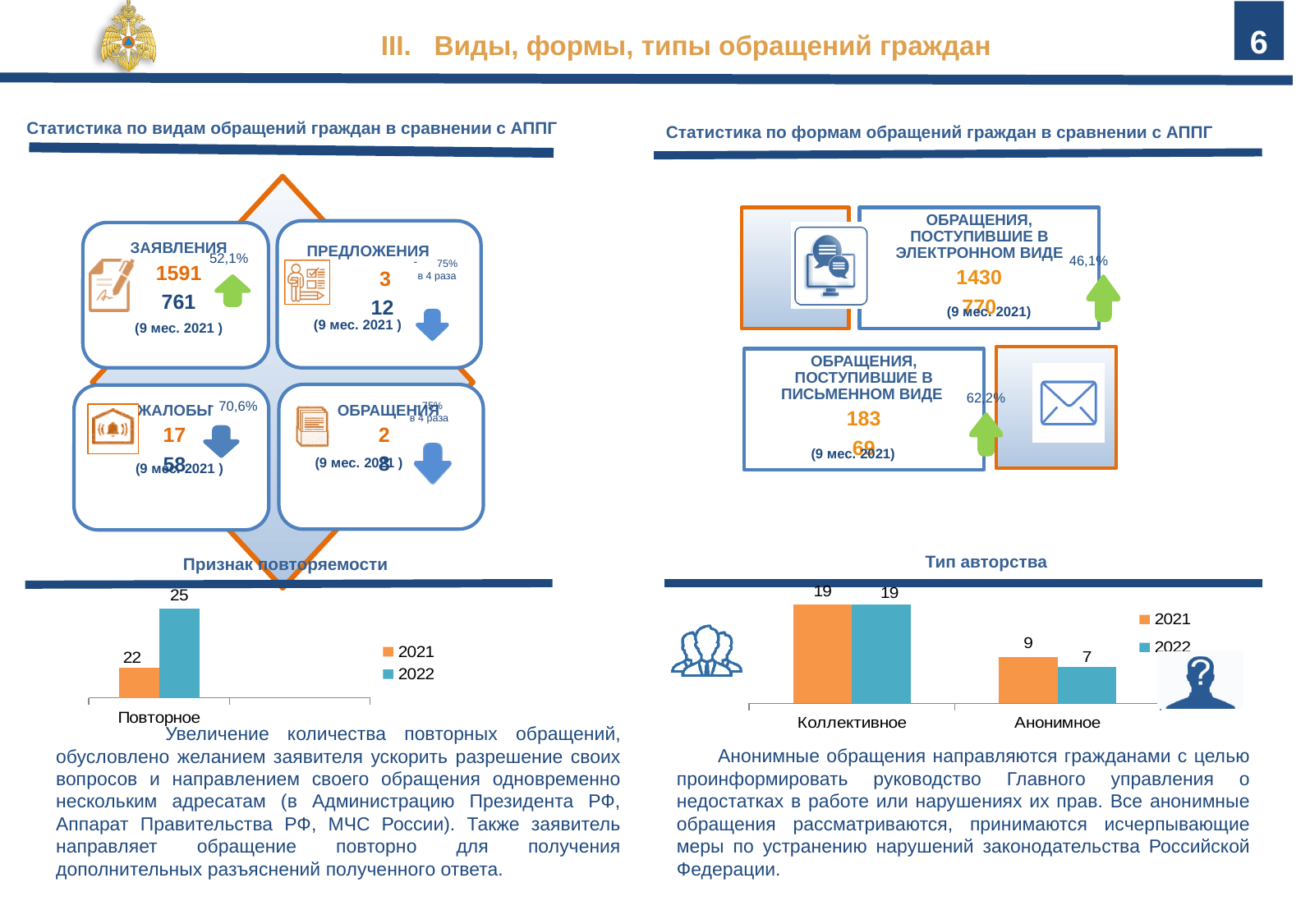
In the 'Признак повторяемости' chart, how many series does the legend list? 2 In the 'Признак повторяемости' chart, what is the value for 2022 for 'Повторное'? 25 In the 'Тип авторства' chart, which category has the lowest 2022 value? Анонимное In the 'Тип авторства' chart, what is the 2022 value for 'Анонимное'? 7 In the 'Признак повторяемости' chart, what is the value for 2021 for 'Повторное'? 22 In the 'Тип авторства' chart, what is the 2021 value for 'Коллективное'? 19 In the 'Признак повторяемости' chart, what is the difference between the 2022 and 2021 values for 'Повторное'? 3 In the 'Признак повторяемости' chart, which series has the larger value for 'Повторное', 2021 or 2022? 2022 In the 'Тип авторства' chart, what is the difference between the 2021 and 2022 values for 'Анонимное'? 2 In the 'Тип авторства' chart, how many categories are shown on the x axis? 2 What kind of chart is the 'Признак повторяемости' chart? bar chart In the 'Тип авторства' chart, what is the 2021 value for 'Анонимное'? 9